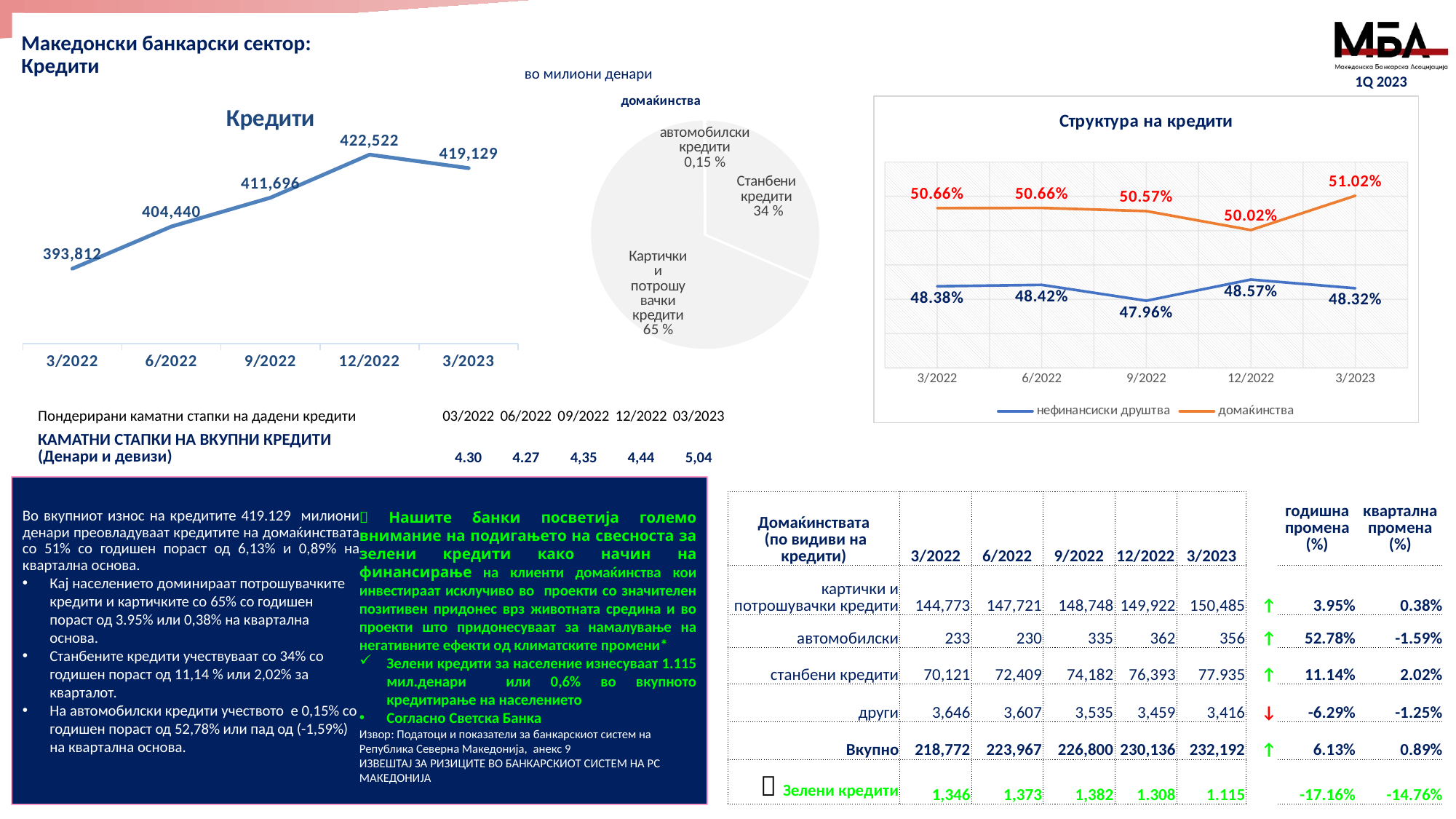
In the 'Кредити' line chart, which period has the highest value? 12/2022 In the 'Кредити' line chart, what is the value for 12/2022? 422,522 In the 'Структура на кредити' chart, which series is larger at 12/2022, 'нефинансиски друштва' or 'домаќинства'? домаќинства In the 'домаќинства' pie chart, what share do 'Станбени кредити' have? 34 % In the 'Структура на кредити' chart, what is the value for 'нефинансиски друштва' at 9/2022? 47.96% In the 'Структура на кредити' chart, what is the value for 'домаќинства' at 3/2023? 51.02% In the 'домаќинства' pie chart, which slice is the smallest? автомобилски кредити In the 'Кредити' line chart, what is the value for 3/2022? 393,812 In the 'Кредити' line chart, do the values rise or fall from 3/2022 to 12/2022? rise In the 'Кредити' line chart, what is the difference between the values for 12/2022 and 3/2023? 3,393 In the 'Кредити' line chart, how many data points are plotted? 5 In the 'Структура на кредити' chart, how many series does the legend list? 2